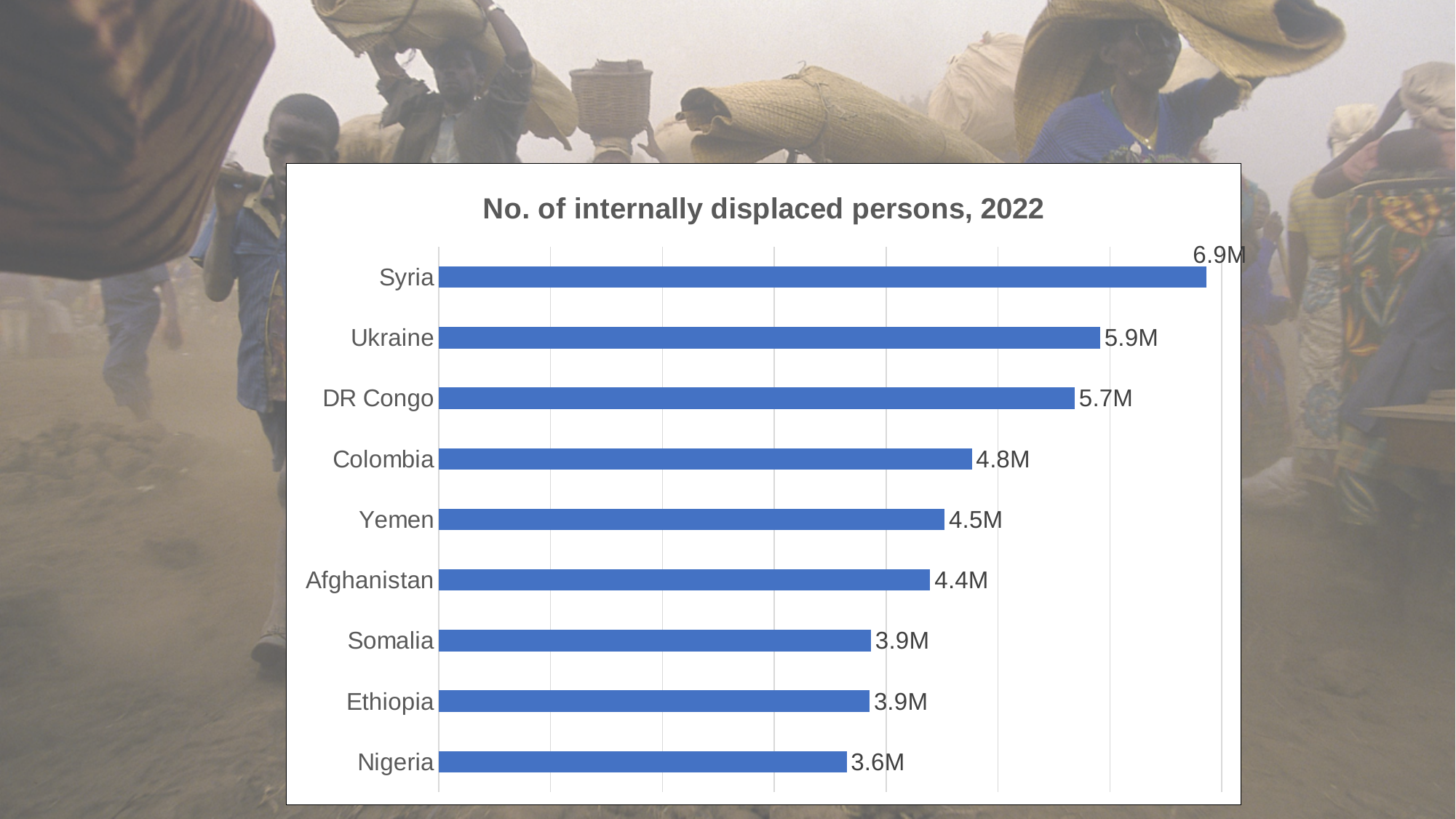
What is the difference between the values for Colombia and Afghanistan? 0.4M What kind of chart is shown on the slide? Bar chart Which has a larger value, DR Congo or Yemen? DR Congo How many countries are shown in the chart? 9 What is the number of internally displaced persons for Nigeria? 3.6M What is the number of internally displaced persons for Ukraine? 5.9M Which country has the lowest number of internally displaced persons? Nigeria What is the number of internally displaced persons for Colombia? 4.8M What is the title of the chart? No. of internally displaced persons, 2022 What is the difference between the values for Syria and Ukraine? 1.0M What is the value for Somalia? 3.9M Which country has the highest number of internally displaced persons? Syria